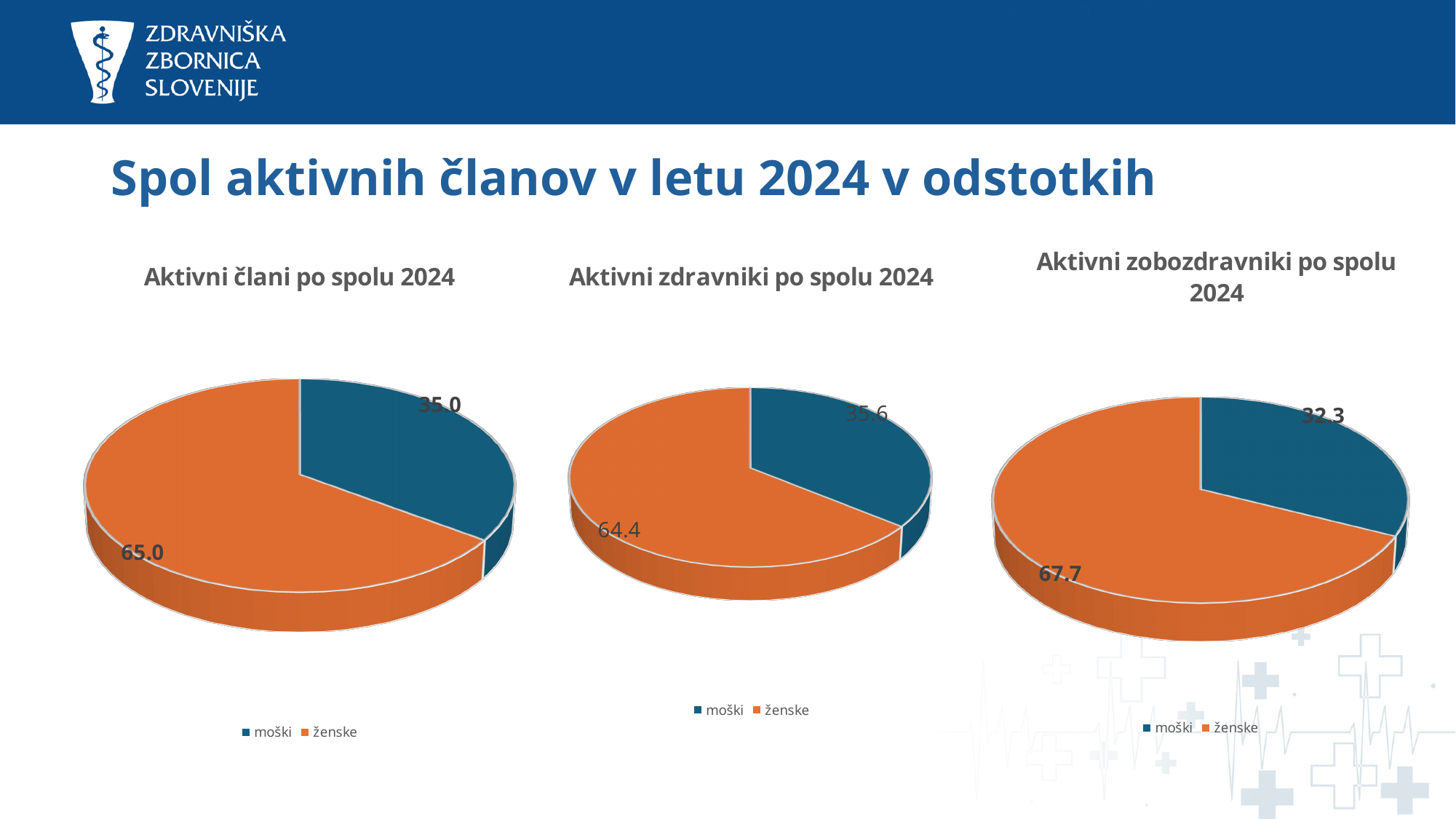
In the chart titled 'Aktivni zobozdravniki po spolu 2024', what is the difference between the ženske and moški values? 35.4 In the chart titled 'Aktivni zdravniki po spolu 2024', what is the value for moški? 35.6 In the chart titled 'Aktivni zobozdravniki po spolu 2024', which category has the largest slice? ženske In the chart titled 'Aktivni zobozdravniki po spolu 2024', what is the value for moški? 32.3 In the chart titled 'Aktivni člani po spolu 2024', what is the difference between the ženske and moški values? 30.0 How many categories does the legend of the chart titled 'Aktivni člani po spolu 2024' list? 2 In the chart titled 'Aktivni zobozdravniki po spolu 2024', what is the value for ženske? 67.7 What kind of chart is the chart titled 'Aktivni zdravniki po spolu 2024'? pie chart In the chart titled 'Aktivni zdravniki po spolu 2024', which category has the smallest slice? moški In the chart titled 'Aktivni člani po spolu 2024', what is the value for ženske? 65.0 In the chart titled 'Aktivni zdravniki po spolu 2024', what is the value for ženske? 64.4 In the chart titled 'Aktivni člani po spolu 2024', what is the value for moški? 35.0